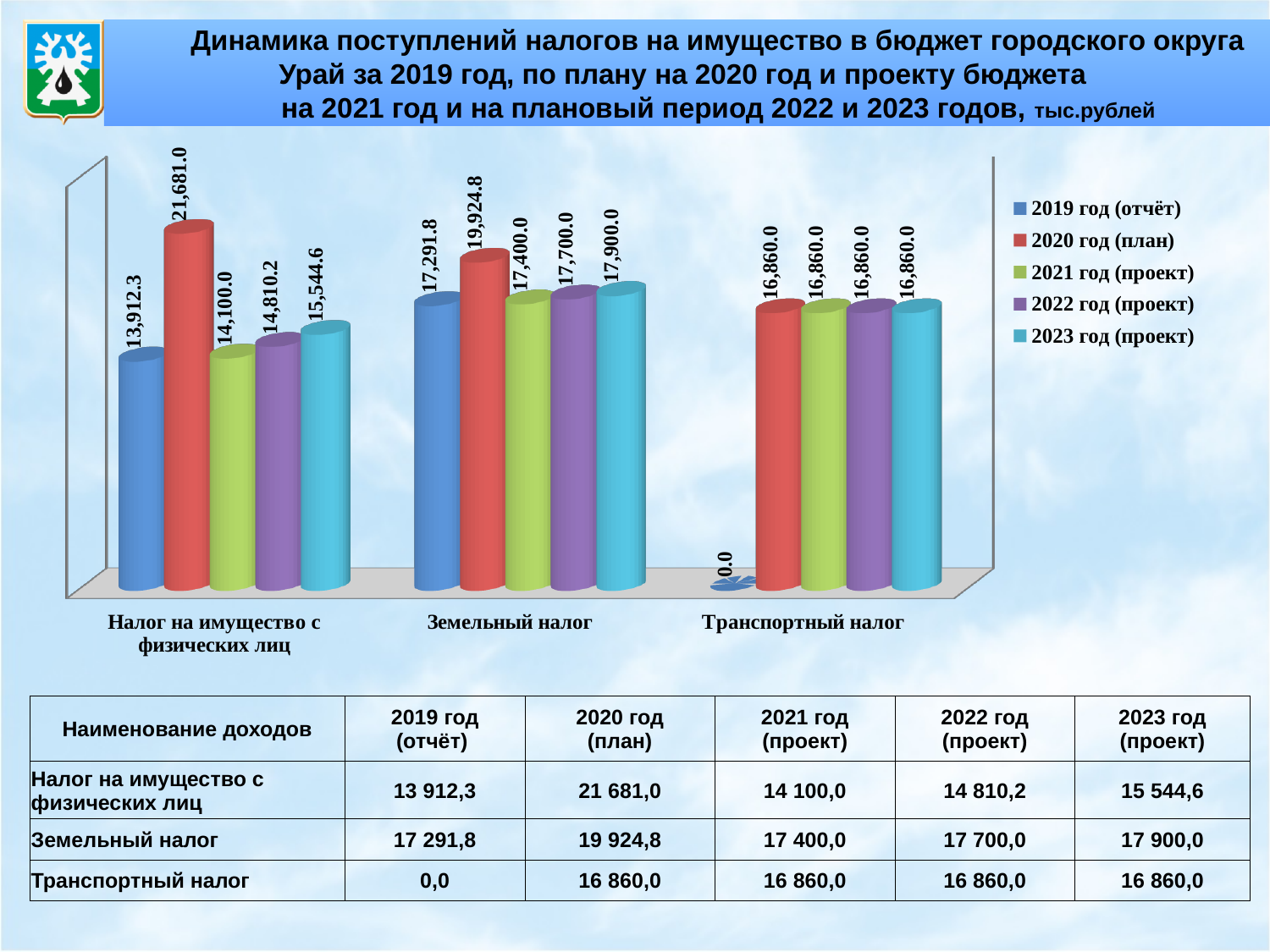
How many tax categories are shown on the x axis of the chart? 3 What is the value for 2020 год (план) for Налог на имущество с физических лиц? 21,681.0 What is the difference between the 2023 год (проект) and 2022 год (проект) values for Налог на имущество с физических лиц? 734.4 What is the value for 2023 год (проект) for Земельный налог? 17,900.0 Which category has the lowest value for 2019 год (отчёт)? Транспортный налог What is the value for 2019 год (отчёт) for Транспортный налог? 0.0 What kind of chart is shown on the slide? bar chart How many series does the legend list? 5 Do the values for Налог на имущество с физических лиц rise or fall from 2021 год (проект) to 2023 год (проект)? rise What is the difference between the 2020 год (план) and 2019 год (отчёт) values for Земельный налог? 2,633.0 Which series has the highest value for Налог на имущество с физических лиц? 2020 год (план) For 2021 год (проект), which is larger: Налог на имущество с физических лиц or Земельный налог? Земельный налог